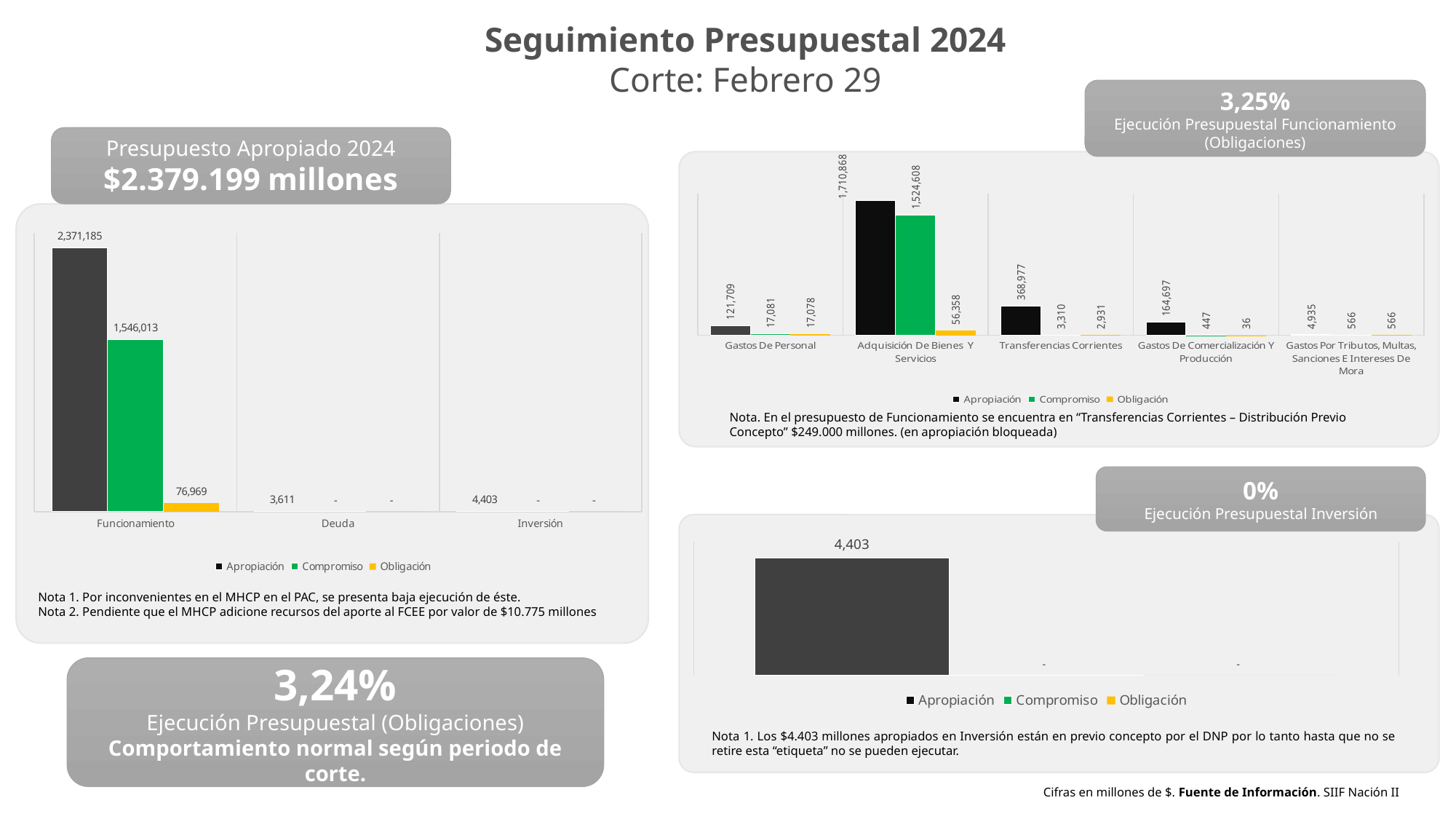
In the bar chart at the top right of the slide, what is the Obligación value for Transferencias Corrientes? 2,931 In the bar chart on the left of the slide, what is the Apropiación value for Deuda? 3,611 In the bar chart at the top right of the slide, what is the Apropiación value for Adquisición De Bienes Y Servicios? 1,710,868 In the bar chart at the top right of the slide, which category has the highest Apropiación value? Adquisición De Bienes Y Servicios In the bar chart on the left of the slide, how many series does the legend list? 3 In the bar chart at the top right of the slide, which is larger: the Compromiso value for Gastos De Personal or the Compromiso value for Transferencias Corrientes? Gastos De Personal In the bar chart on the left of the slide, how many categories are shown on the x axis? 3 In the bar chart on the left of the slide, what is the difference between the Apropiación and Compromiso values for Funcionamiento? 825,172 In the bar chart on the left of the slide, what is the Obligación value for Funcionamiento? 76,969 In the bar chart at the bottom right of the slide, what is the Apropiación value shown? 4,403 In the bar chart on the left of the slide, what is the Apropiación value for Funcionamiento? 2,371,185 In the bar chart at the top right of the slide, which category has the lowest Apropiación value? Gastos Por Tributos, Multas, Sanciones E Intereses De Mora